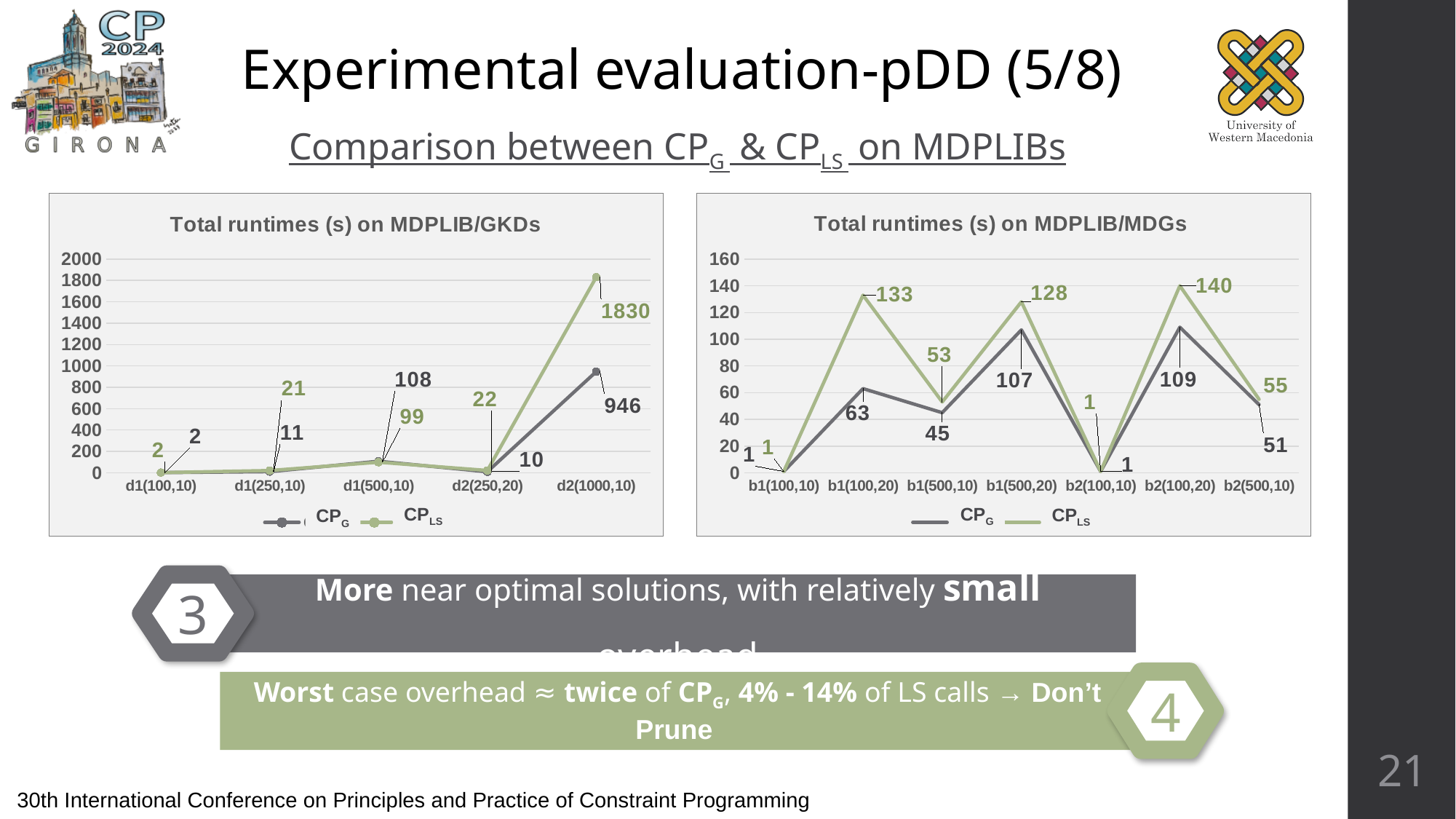
In the 'Total runtimes (s) on MDPLIB/GKDs' chart, what is the difference between the CP_LS and CP_G values for d2(1000,10)? 884 In the 'Total runtimes (s) on MDPLIB/MDGs' chart, which category has the highest CP_LS value? b2(100,20) In the 'Total runtimes (s) on MDPLIB/GKDs' chart, what is the CP_G value for d1(500,10)? 108 In the 'Total runtimes (s) on MDPLIB/MDGs' chart, what is the CP_G value for b1(500,20)? 107 In the 'Total runtimes (s) on MDPLIB/MDGs' chart, which is larger for b1(500,10): the CP_G value or the CP_LS value? CP_LS In the 'Total runtimes (s) on MDPLIB/MDGs' chart, what is the difference between the CP_LS and CP_G values for b2(100,20)? 31 What type of chart is the 'Total runtimes (s) on MDPLIB/MDGs' chart? Line chart In the 'Total runtimes (s) on MDPLIB/MDGs' chart, how many series does the legend list? 2 In the 'Total runtimes (s) on MDPLIB/MDGs' chart, what is the CP_LS value for b1(100,20)? 133 In the 'Total runtimes (s) on MDPLIB/GKDs' chart, how many categories are shown on the x axis? 5 In the 'Total runtimes (s) on MDPLIB/GKDs' chart, which category has the highest CP_G value? d2(1000,10) In the 'Total runtimes (s) on MDPLIB/GKDs' chart, what is the CP_LS value for d2(1000,10)? 1830